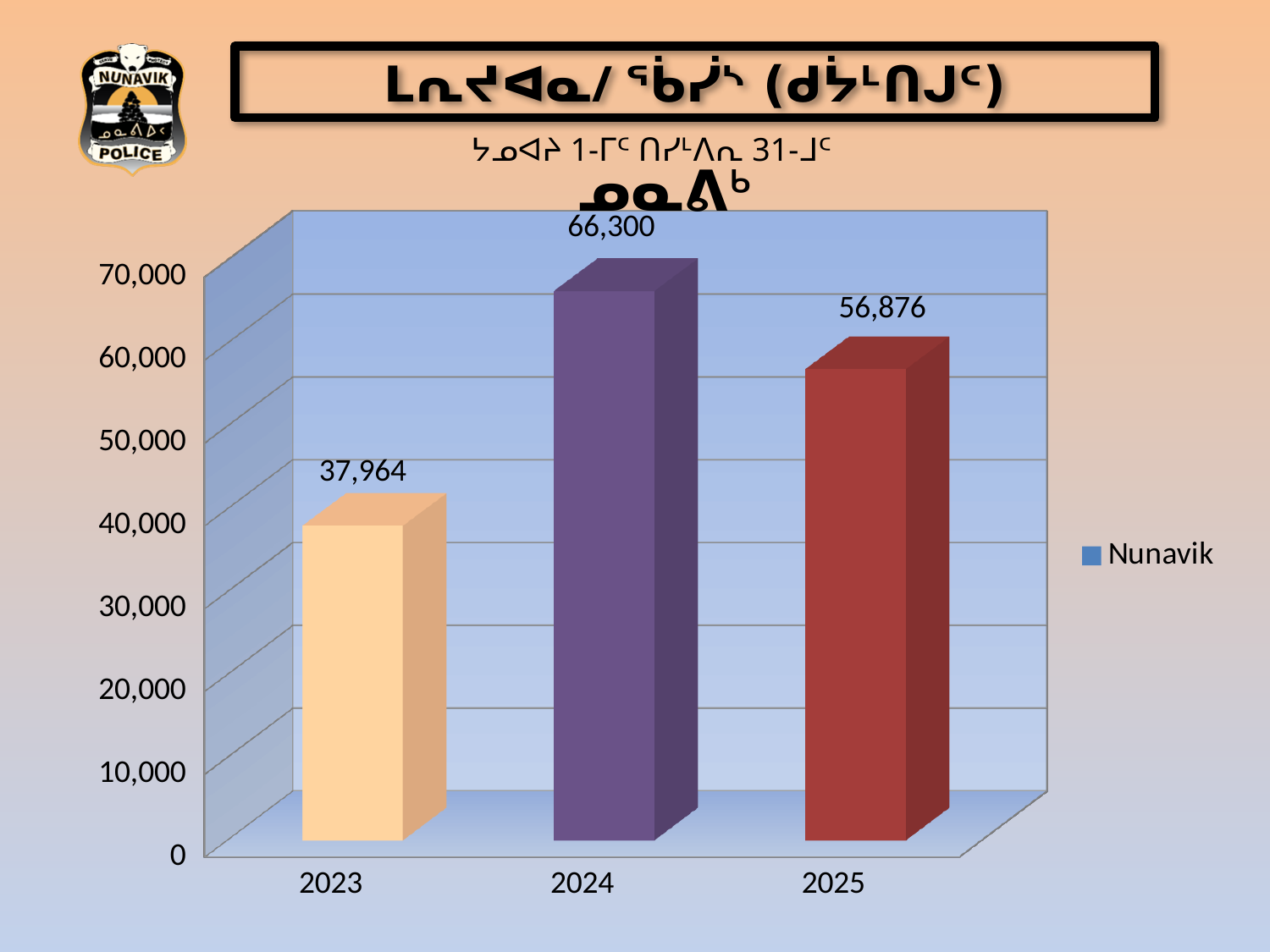
What series name does the legend list? Nunavik What is the difference between the values for 2024 and 2025? 9,424 Is the value for 2025 greater or less than 50,000? greater What is the value for 2023? 37,964 What is the difference between the values for 2024 and 2023? 28,336 Which year has the highest value? 2024 How many years are shown on the x axis? 3 What kind of chart is shown on the slide? bar chart What is the value for 2025? 56,876 What is the value for 2024? 66,300 Which is larger, the value for 2025 or the value for 2023? 2025 Which year has the lowest value? 2023